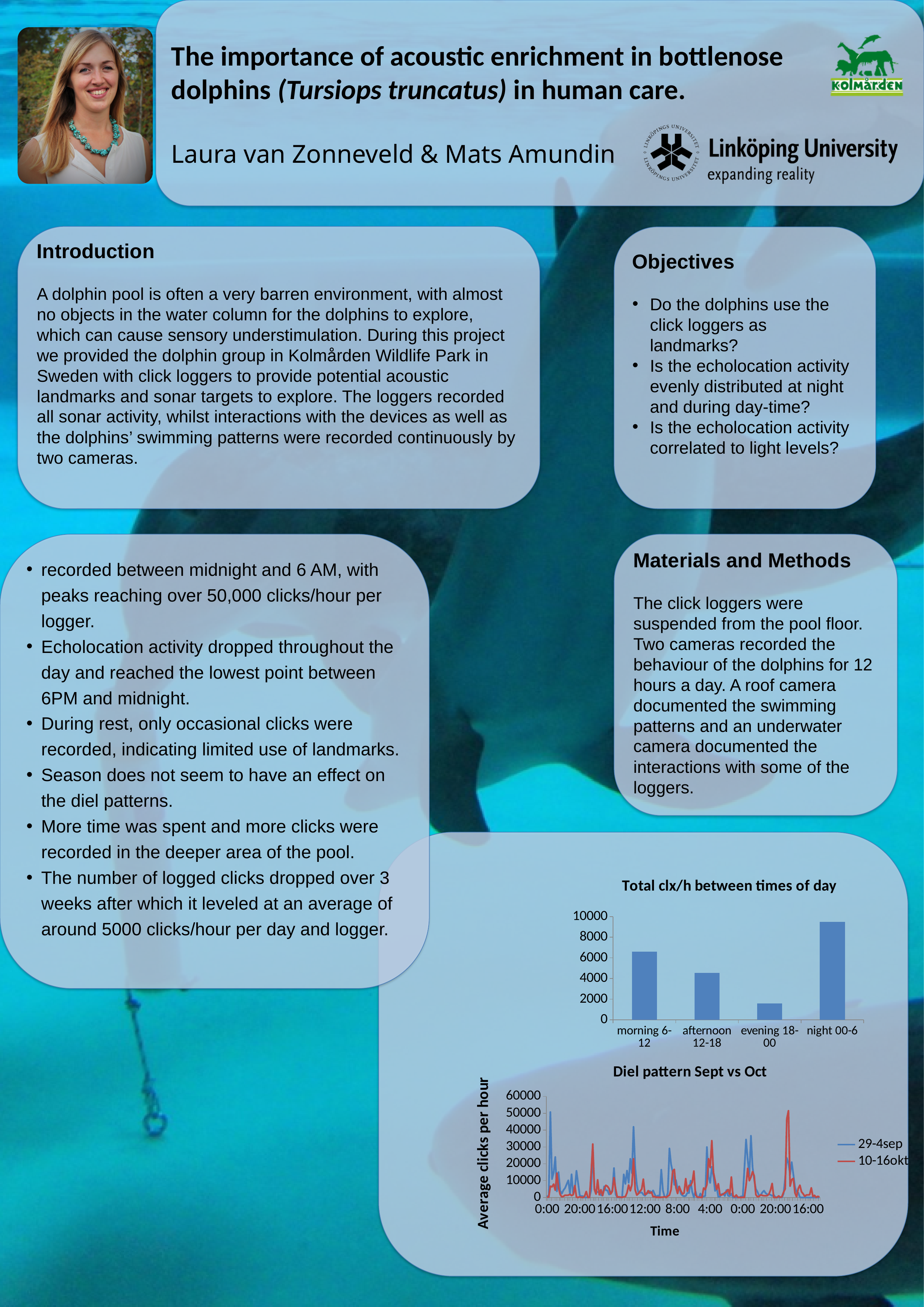
In the chart titled "Total clx/h between times of day", how many time-of-day categories are plotted? 4 In the chart titled "Diel pattern Sept vs Oct", which series is drawn in red? 10-16okt In the chart titled "Total clx/h between times of day", is the value for night 00-6 greater or less than 8000? greater In the chart titled "Total clx/h between times of day", is the value for afternoon 12-18 greater or less than 6000? less In the chart titled "Total clx/h between times of day", is the value for evening 18-00 greater or less than 2000? less In the chart titled "Total clx/h between times of day", which time of day has the highest value? night 00-6 In the chart titled "Total clx/h between times of day", what kind of chart is shown? bar chart In the chart titled "Total clx/h between times of day", which is larger, the value for morning 6-12 or the value for afternoon 12-18? morning 6-12 In the chart titled "Diel pattern Sept vs Oct", what kind of chart is shown? line chart In the chart titled "Diel pattern Sept vs Oct", what is the label of the y axis? Average clicks per hour In the chart titled "Diel pattern Sept vs Oct", how many series does the legend list? 2 In the chart titled "Total clx/h between times of day", which time of day has the lowest value? evening 18-00